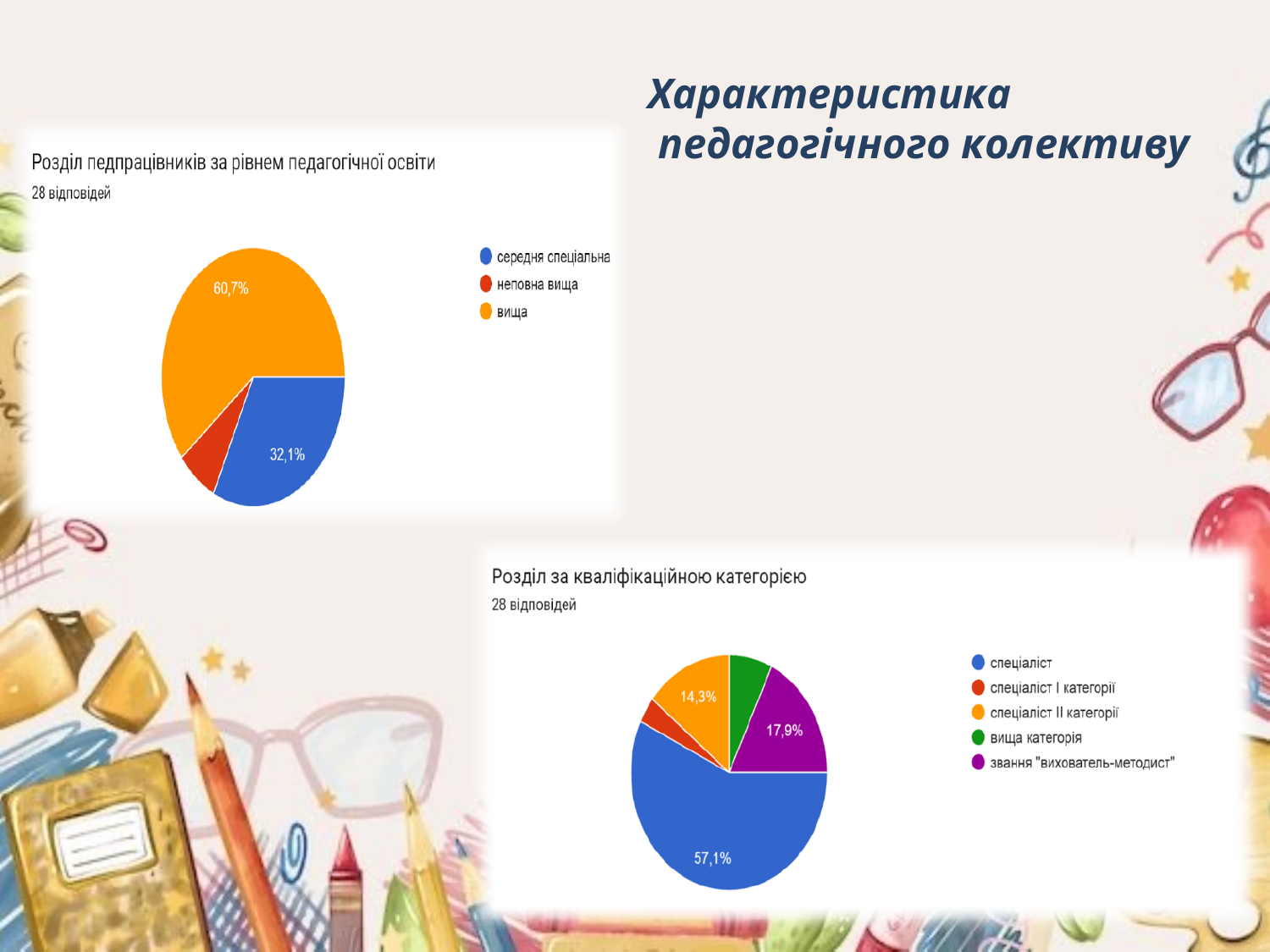
In the chart "Розділ за кваліфікаційною категорією", what share is shown for "спеціаліст II категорії"? 14,3% In the chart "Розділ за кваліфікаційною категорією", what share is shown for "спеціаліст"? 57,1% In the chart "Розділ педпрацівників за рівнем педагогічної освіти", which category has the largest slice? вища In the chart "Розділ педпрацівників за рівнем педагогічної освіти", what is the difference between the shares for "вища" and "середня спеціальна"? 28,6% How many categories does the legend of the chart "Розділ педпрацівників за рівнем педагогічної освіти" list? 3 In the chart "Розділ педпрацівників за рівнем педагогічної освіти", what share is shown for "вища"? 60,7% What kind of chart is the top-left chart titled "Розділ педпрацівників за рівнем педагогічної освіти"? pie chart In the chart "Розділ за кваліфікаційною категорією", what share is shown for "звання "вихователь-методист""? 17,9% In the chart "Розділ педпрацівників за рівнем педагогічної освіти", which category has the smallest slice? неповна вища In the chart "Розділ педпрацівників за рівнем педагогічної освіти", what share is shown for "середня спеціальна"? 32,1% In the chart "Розділ за кваліфікаційною категорією", which is larger: the share for "спеціаліст II категорії" or for "звання "вихователь-методист""? звання "вихователь-методист" How many categories does the legend of the chart "Розділ за кваліфікаційною категорією" list? 5